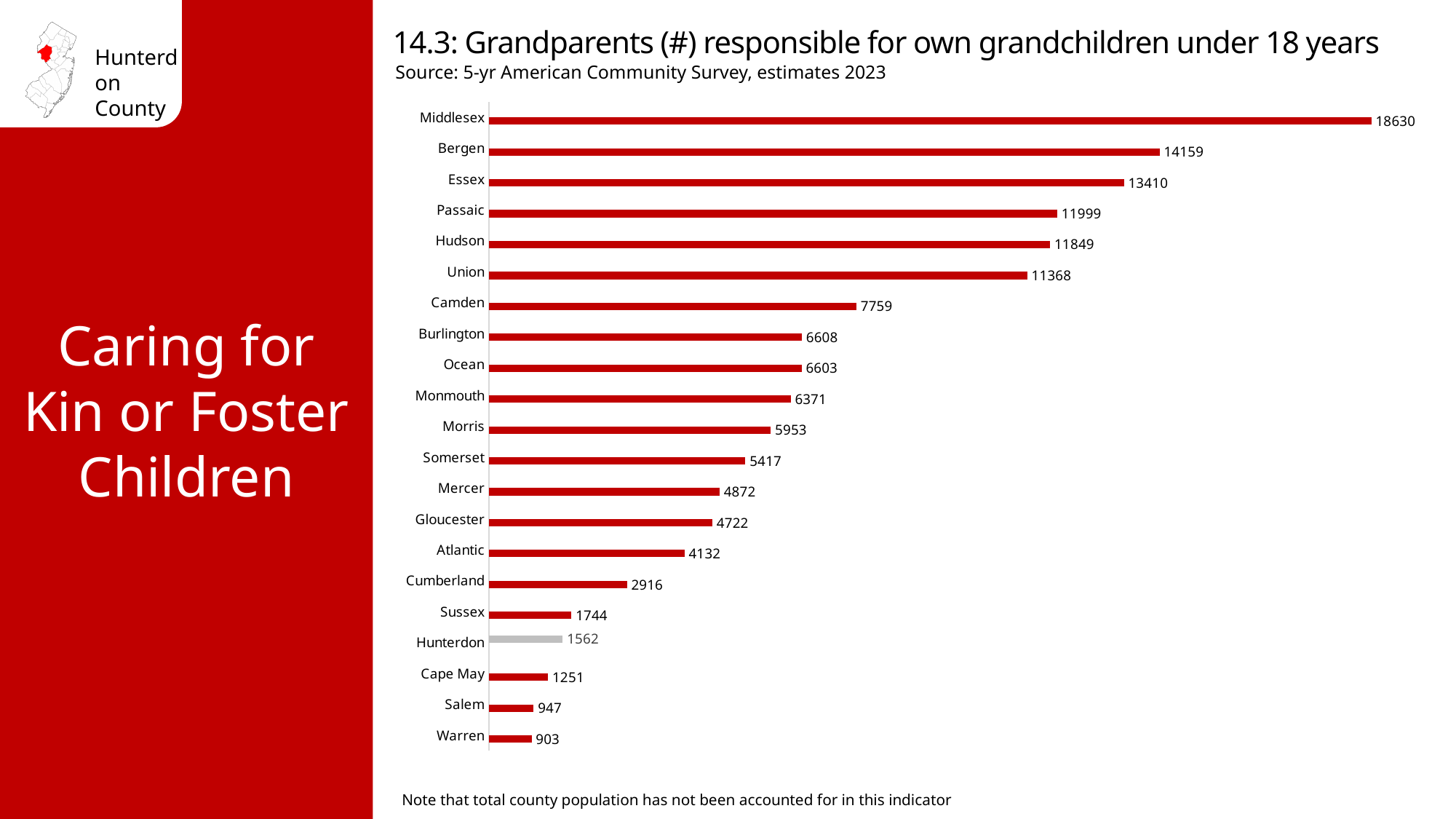
What is the difference between the values for Bergen and Essex? 749 Which county has the lowest value? Warren How many counties are shown in the chart? 21 Which is larger, the value for Passaic or the value for Union? Passaic Which is larger, the value for Mercer or the value for Atlantic? Mercer What is the difference between the values for Sussex and Hunterdon? 182 What is the value for Middlesex? 18630 What kind of chart is shown on the slide? Bar chart Which county has the highest value? Middlesex What is the value for Hunterdon? 1562 What is the value for Camden? 7759 Which county's bar is shown in grey rather than red? Hunterdon